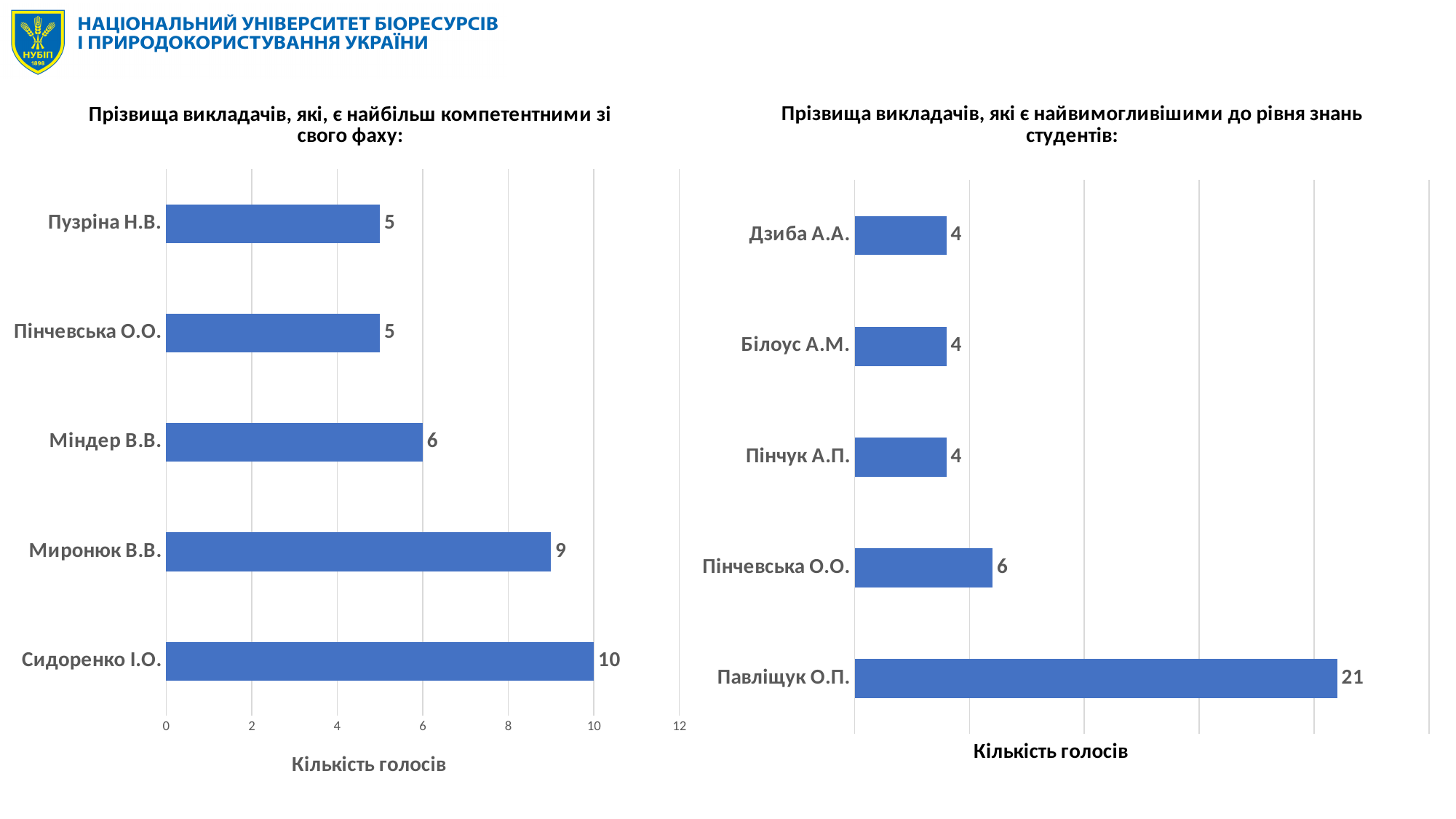
What type of chart is the right chart? Bar chart In the left chart, which lecturer has the highest number of votes? Сидоренко І.О. In the right chart, who received more votes, Пінчевська О.О. or Дзиба А.А.? Пінчевська О.О. In the left chart, how many votes did Міндер В.В. receive? 6 In the left chart, what is the difference in votes between Сидоренко І.О. and Миронюк В.В.? 1 In the right chart, how many votes did Пінчевська О.О. receive? 6 In the right chart, how many votes did Павліщук О.П. receive? 21 In the right chart, what is the difference in votes between Павліщук О.П. and Пінчевська О.О.? 15 In the left chart, how many lecturers are listed? 5 In the left chart, how many votes did Сидоренко І.О. receive? 10 In the right chart, which lecturer has the highest number of votes? Павліщук О.П. What is the x-axis title of the left chart? Кількість голосів